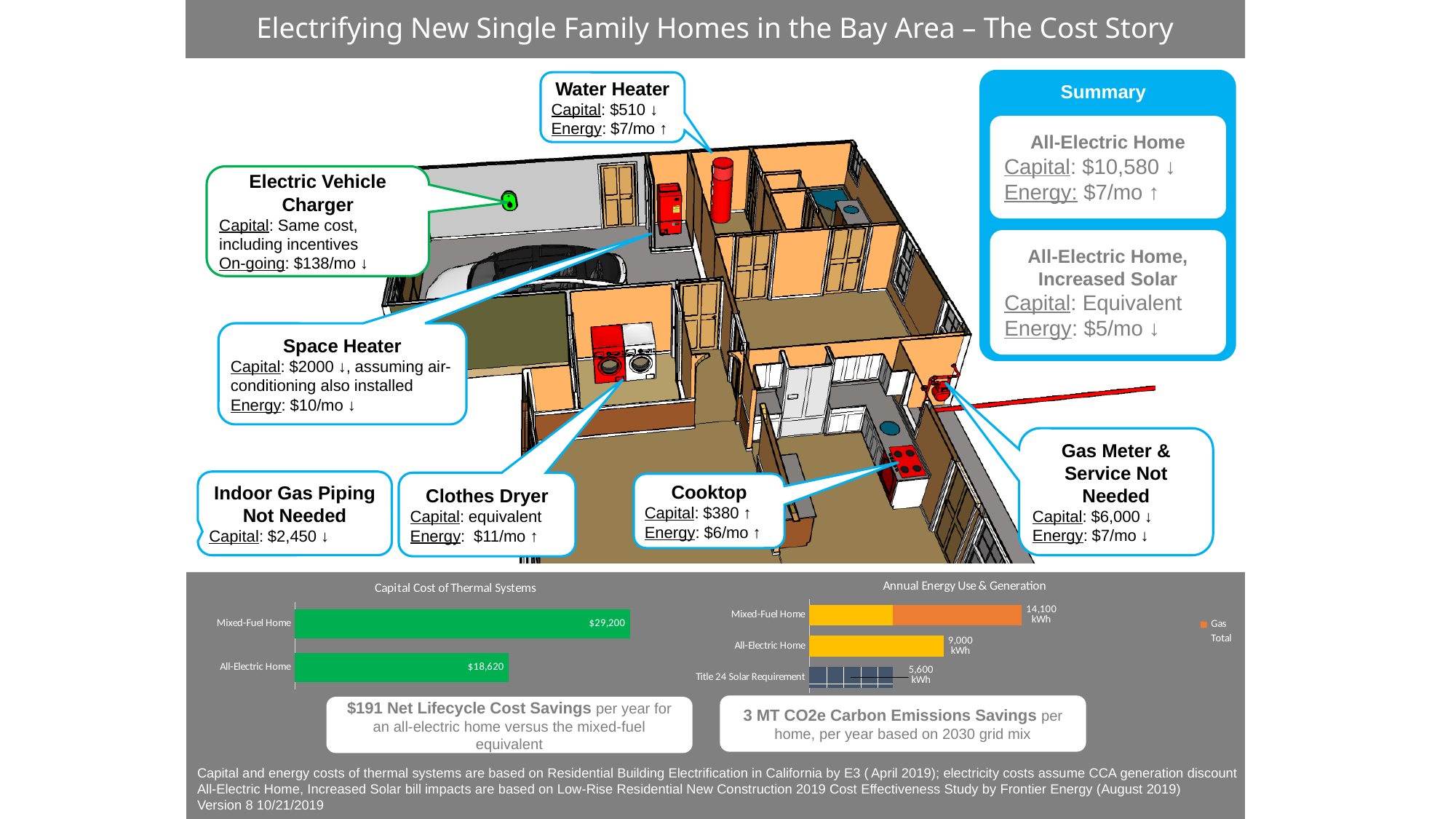
In the Annual Energy Use & Generation chart, what is the value for Title 24 Solar Requirement? 5,600 kWh In the Annual Energy Use & Generation chart, what is the value for All-Electric Home? 9,000 kWh In the Annual Energy Use & Generation chart, how many categories are shown? 3 In the Capital Cost of Thermal Systems chart, how many categories are shown? 2 In the Capital Cost of Thermal Systems chart, what is the value for All-Electric Home? $18,620 In the Annual Energy Use & Generation chart, is the value for Mixed-Fuel Home larger or smaller than the value for All-Electric Home? Larger In the Annual Energy Use & Generation chart, which category has the lowest value? Title 24 Solar Requirement In the Capital Cost of Thermal Systems chart, what is the difference between the Mixed-Fuel Home and All-Electric Home values? $10,580 What kind of chart is the Capital Cost of Thermal Systems chart? Bar chart In the Capital Cost of Thermal Systems chart, which category has the highest value? Mixed-Fuel Home In the Capital Cost of Thermal Systems chart, what is the value for Mixed-Fuel Home? $29,200 In the Annual Energy Use & Generation chart, what is the total value for Mixed-Fuel Home? 14,100 kWh